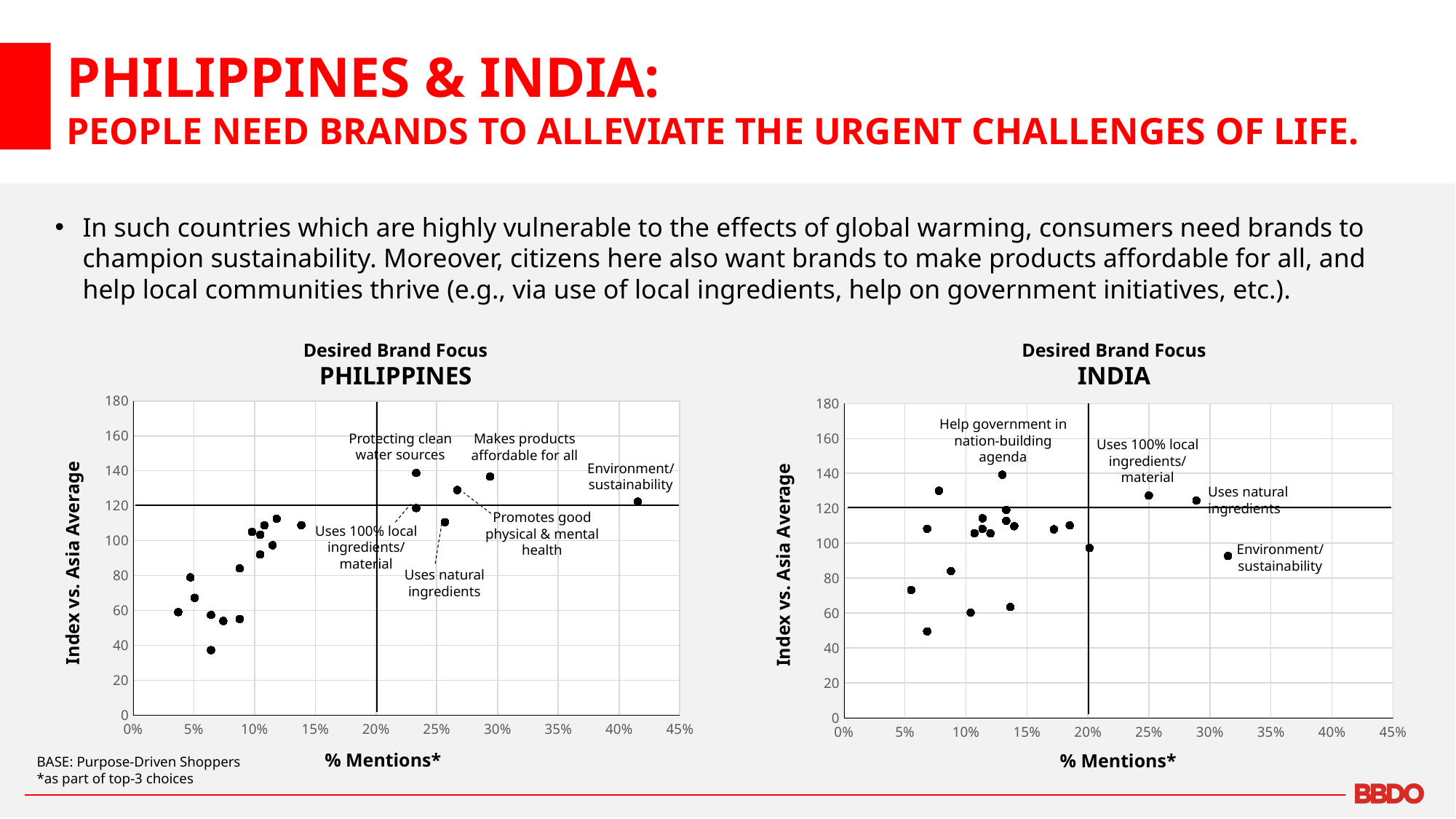
What kind of chart is the Desired Brand Focus PHILIPPINES chart? Scatter chart On the Desired Brand Focus PHILIPPINES chart, is the Index vs. Asia Average for Uses natural ingredients greater or less than 120? less On the Desired Brand Focus INDIA chart, which has a higher Index vs. Asia Average: Help government in nation-building agenda or Environment/sustainability? Help government in nation-building agenda On the Desired Brand Focus PHILIPPINES chart, which labeled point has the highest % Mentions? Environment/sustainability On the Desired Brand Focus PHILIPPINES chart, which has a higher % Mentions: Environment/sustainability or Makes products affordable for all? Environment/sustainability On the Desired Brand Focus INDIA chart, is the Index vs. Asia Average for Help government in nation-building agenda greater or less than 120? greater On the Desired Brand Focus PHILIPPINES chart, what is the title of the horizontal axis? % Mentions* On the Desired Brand Focus INDIA chart, what is the title of the vertical axis? Index vs. Asia Average On the Desired Brand Focus INDIA chart, is the % Mentions value for Uses natural ingredients greater or less than 25%? greater On the Desired Brand Focus INDIA chart, which labeled point has the lowest Index vs. Asia Average? Environment/sustainability